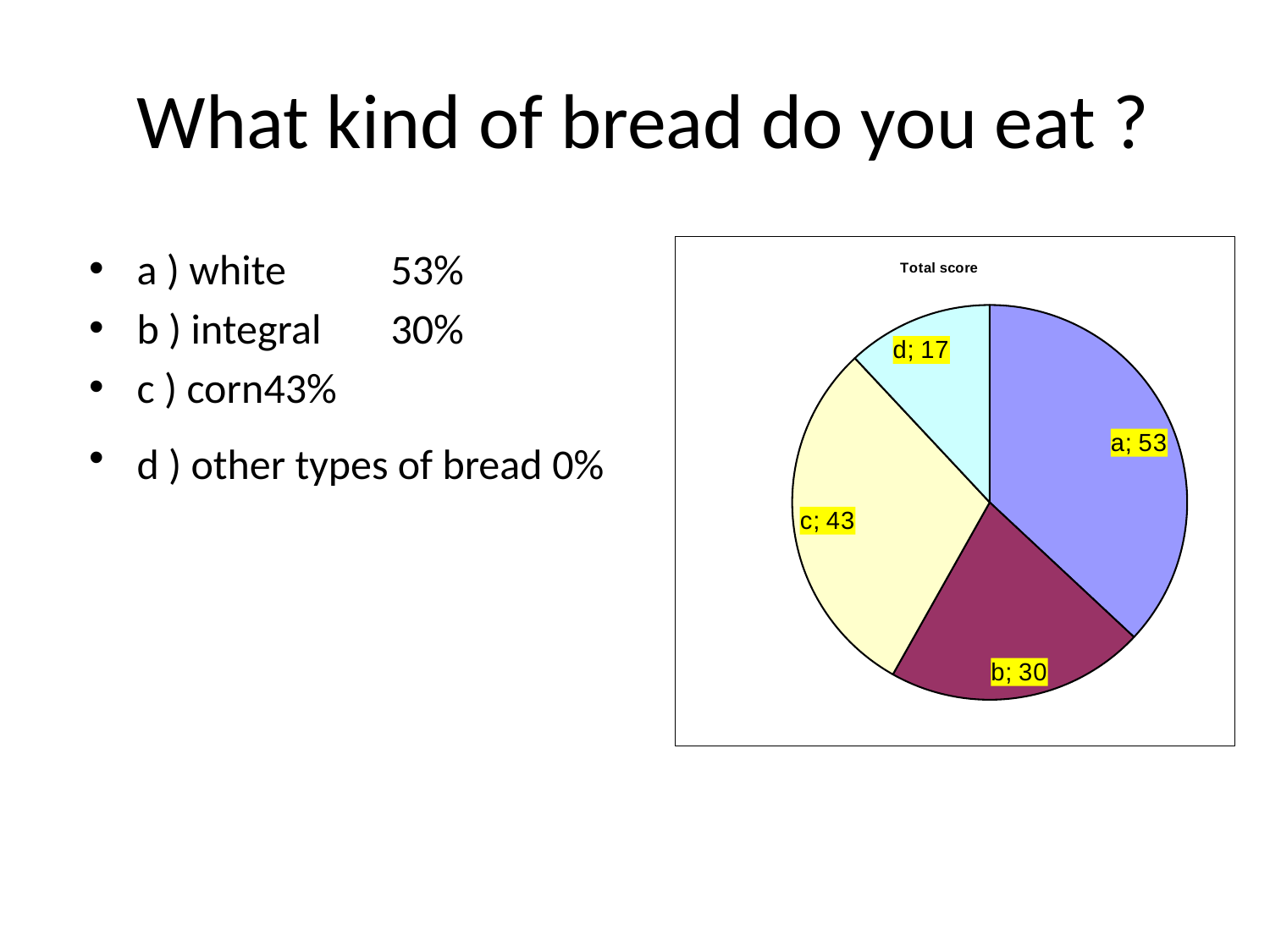
What is the value for slice d in the pie chart? 17 What is the value for slice c in the pie chart? 43 What is the value for slice b in the pie chart? 30 What kind of chart is shown on the slide? pie chart Which is larger, the value for slice b or the value for slice c? c Which slice of the pie chart has the highest value? a How many slices does the pie chart have? 4 What is the title of the chart? Total score What is the difference between the values for slices c and d? 26 What is the difference between the values for slices a and b? 23 Which slice of the pie chart has the lowest value? d What is the value for slice a in the pie chart? 53